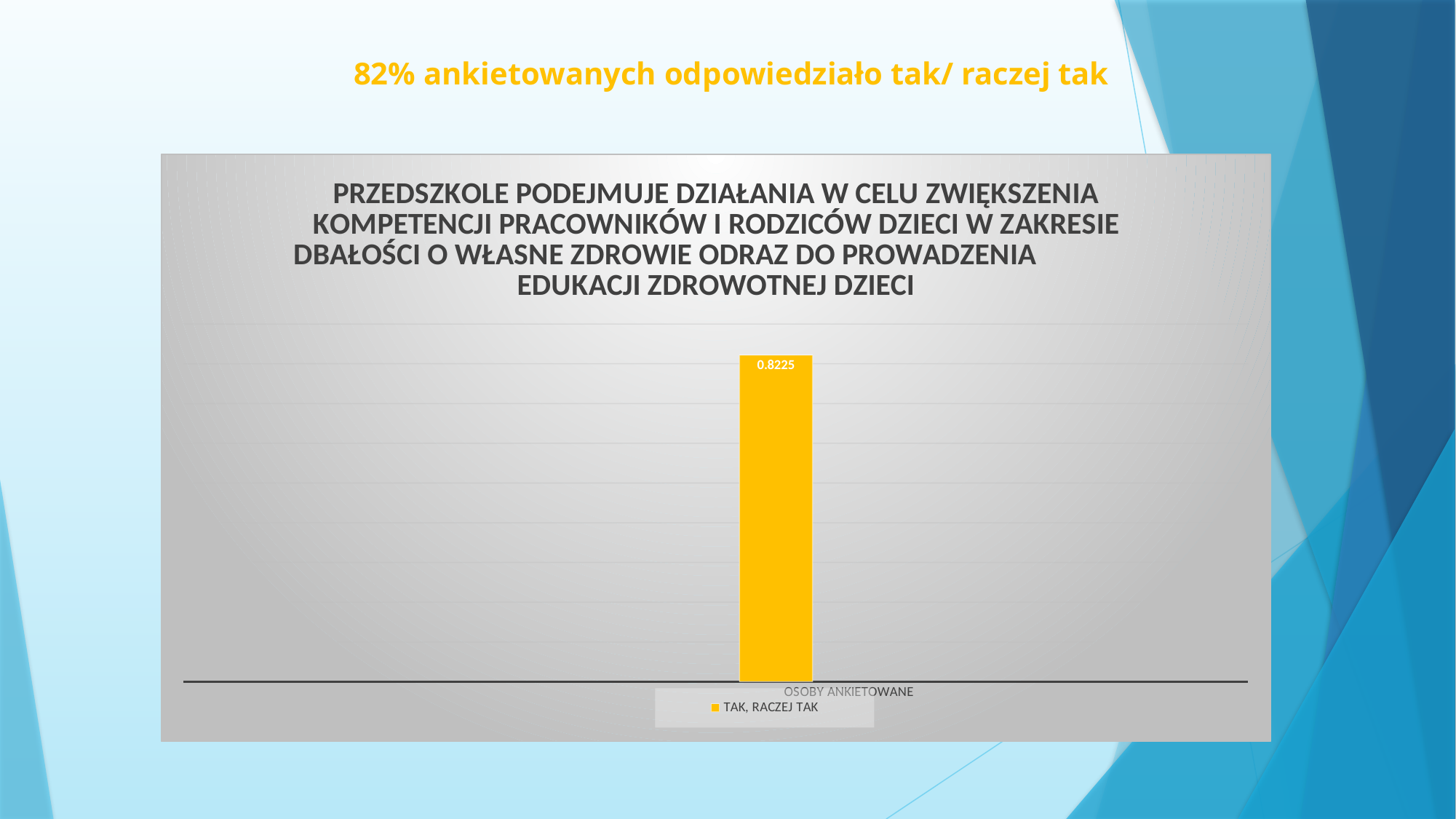
What colour is the bar in the chart? yellow How many bars are plotted in the chart? 1 How many series does the legend list? 1 What kind of chart is shown on the slide? bar chart What is the value of the bar for OSOBY ANKIETOWANE? 0.8225 What is the name of the series listed in the legend? TAK, RACZEJ TAK What is the category label on the x axis? OSOBY ANKIETOWANE What value is shown for the series TAK, RACZEJ TAK? 0.8225